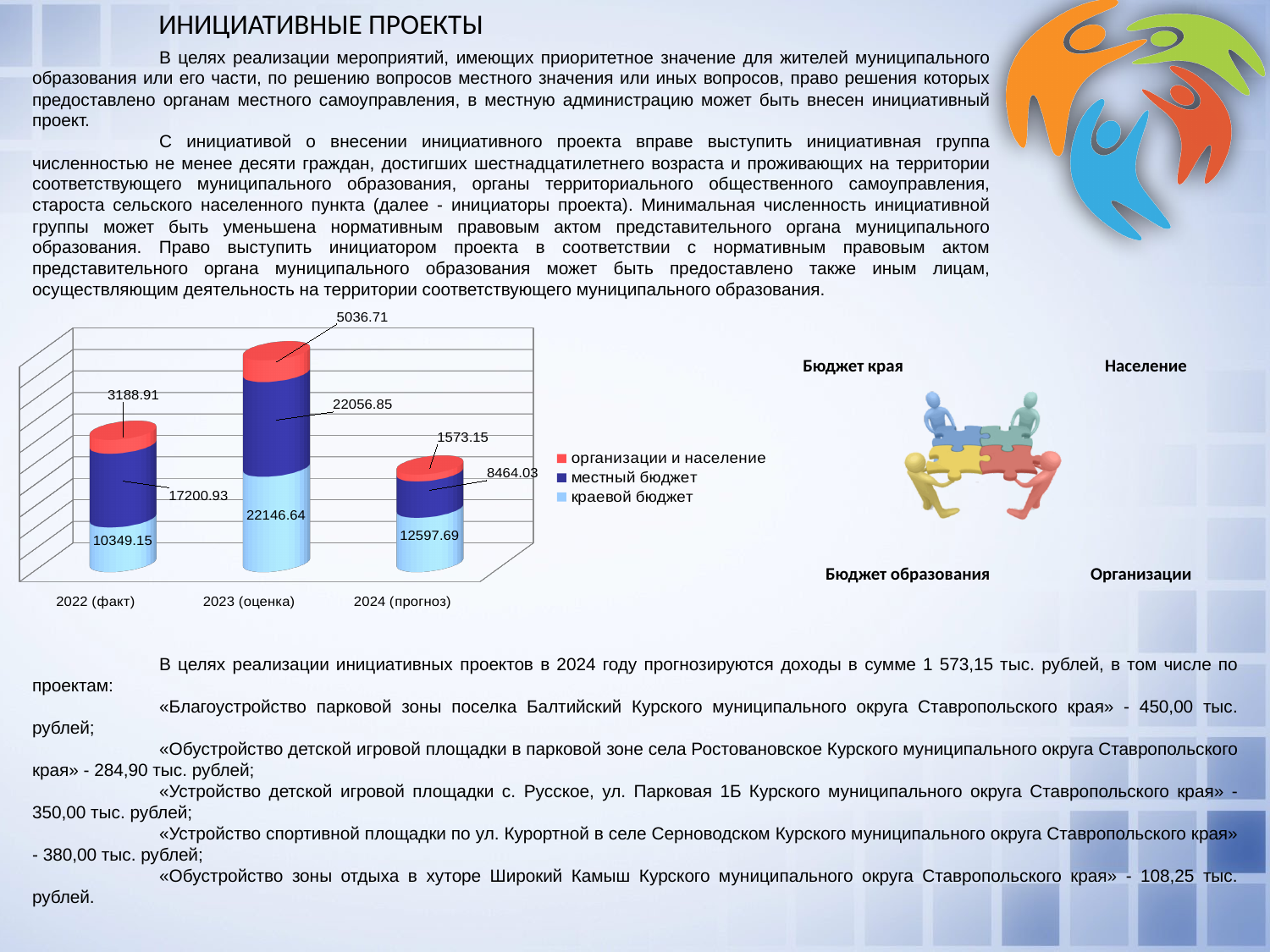
In which year is the value of местный бюджет the lowest? 2024 (прогноз) What is the value of местный бюджет for 2024 (прогноз)? 8464.03 What kind of chart is shown on the slide? Stacked bar chart How many categories are shown on the x axis of the chart? 3 What is the value of краевой бюджет for 2022 (факт)? 10349.15 What is the difference between the краевой бюджет values for 2023 (оценка) and 2022 (факт)? 11797.49 What is the value of местный бюджет for 2023 (оценка)? 22056.85 What is the value of организации и население for 2024 (прогноз)? 1573.15 In which year is the value of организации и население the highest? 2023 (оценка) What is the total of the stacked bar for 2024 (прогноз)? 22634.87 Which is larger for 2022 (факт): местный бюджет or краевой бюджет? местный бюджет How many series does the chart legend list? 3